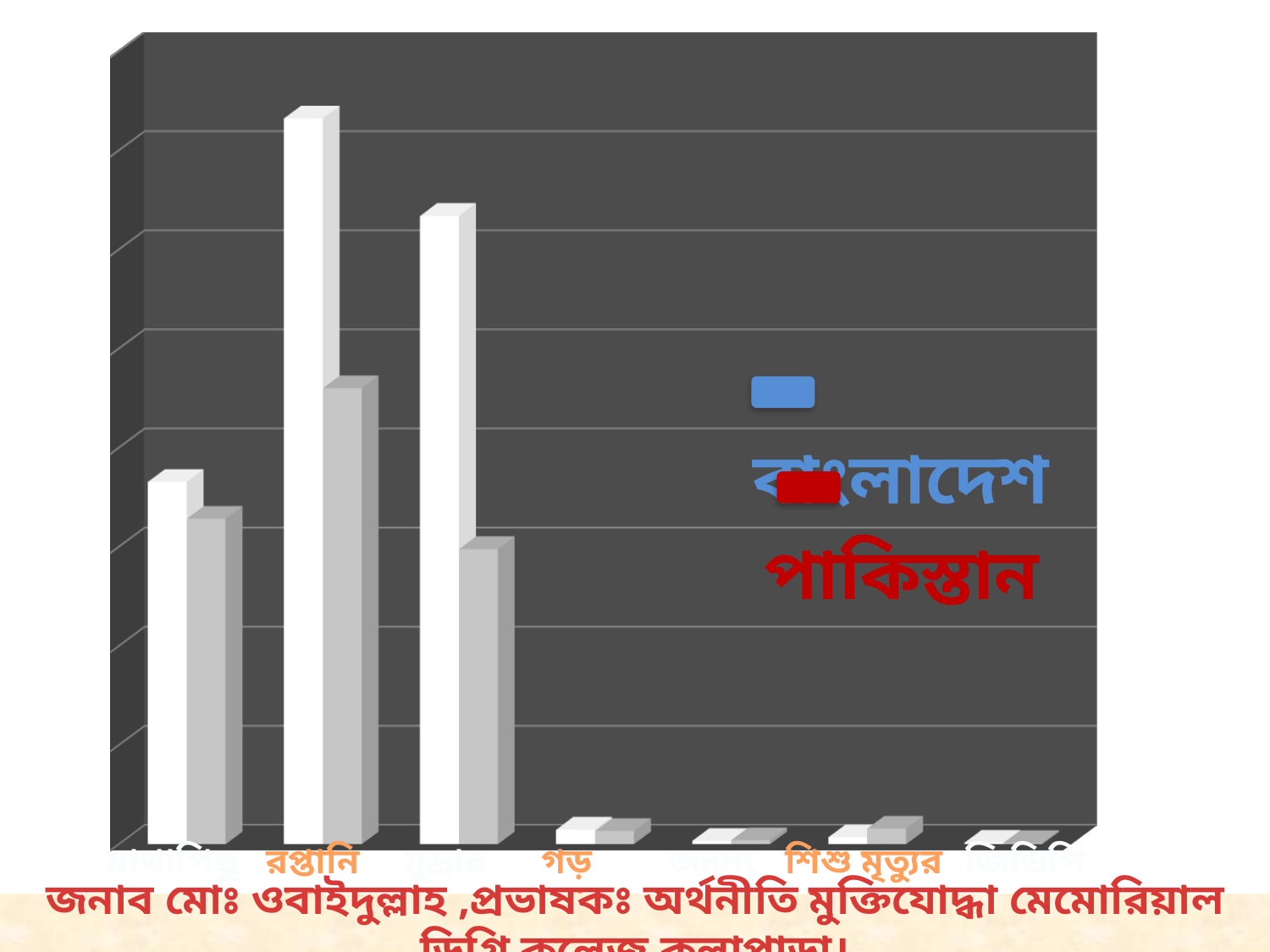
How many series does the legend list? 2 How many categories are plotted along the x axis? 7 Which has the taller front bar, মাথাপিছু or শিশু মৃত্যুর? মাথাপিছু What kind of chart is shown on the slide? bar chart Which colour does the legend assign to পাকিস্তান? red What are the two series named in the legend? বাংলাদেশ and পাকিস্তান Which category has the tallest bar in the chart? রপ্তানি Which has the taller front bar, গড় or রপ্তানি? রপ্তানি Which has the taller front bar, রপ্তানি or মাথাপিছু? রপ্তানি